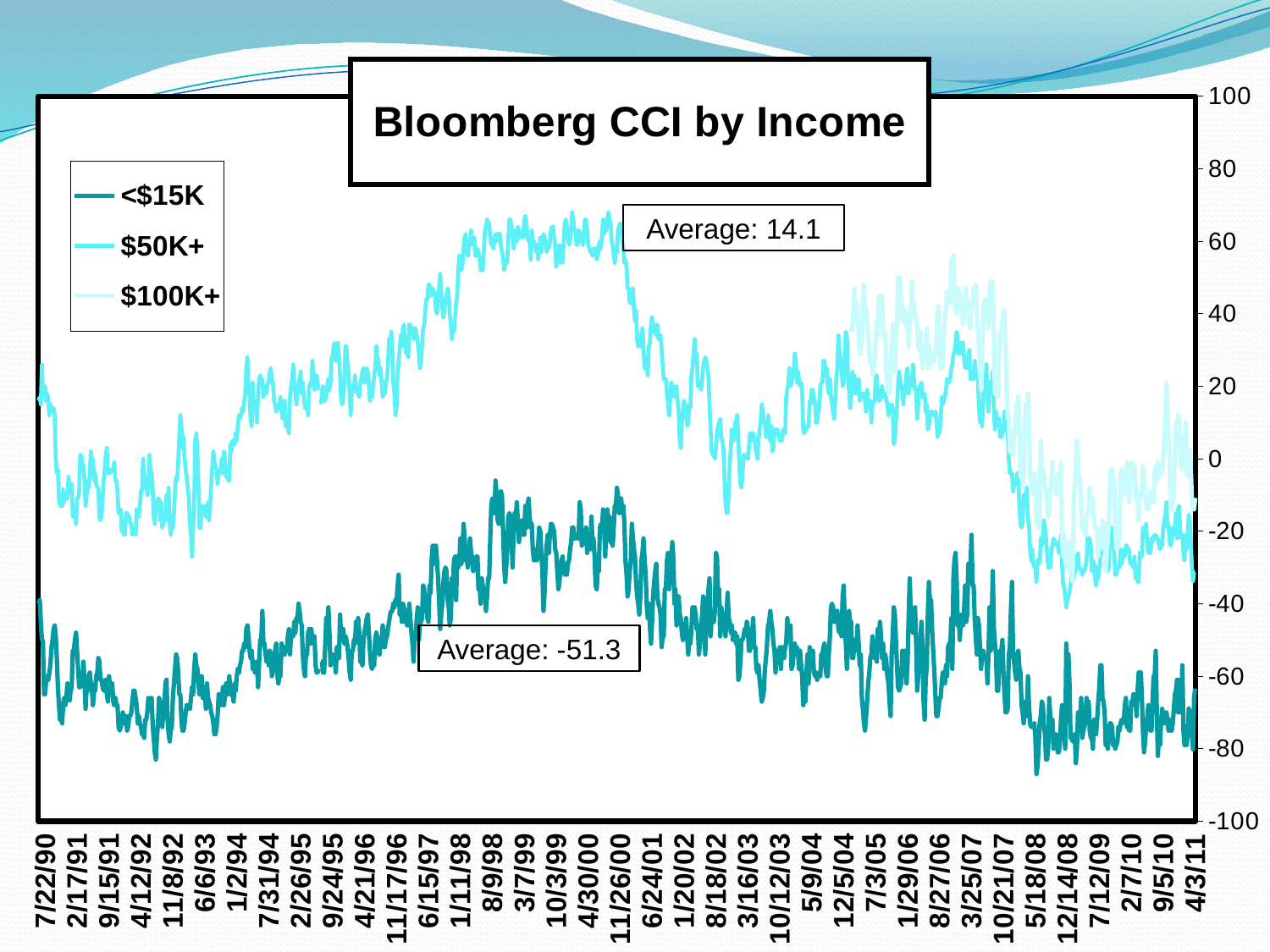
How many series does the legend list? 3 Which series has the lowest values throughout the chart? <$15K Which series reaches the highest value anywhere on the chart? $50K+ What kind of chart is shown on the slide? line chart Which series is higher at 7/22/90, <$15K or $50K+? $50K+ Is the value for the $50K+ series around 3/7/99 greater or less than 40? greater What is the title of the chart? Bloomberg CCI by Income Is the value for the <$15K series at 4/3/11 greater or less than -60? less Is the value for the $50K+ series at 7/22/90 greater or less than 0? greater Which income groups are listed in the legend? <$15K, $50K+, $100K+ What average value is printed in the lower annotation box on the chart? -51.3 What average value is printed in the upper annotation box on the chart? 14.1